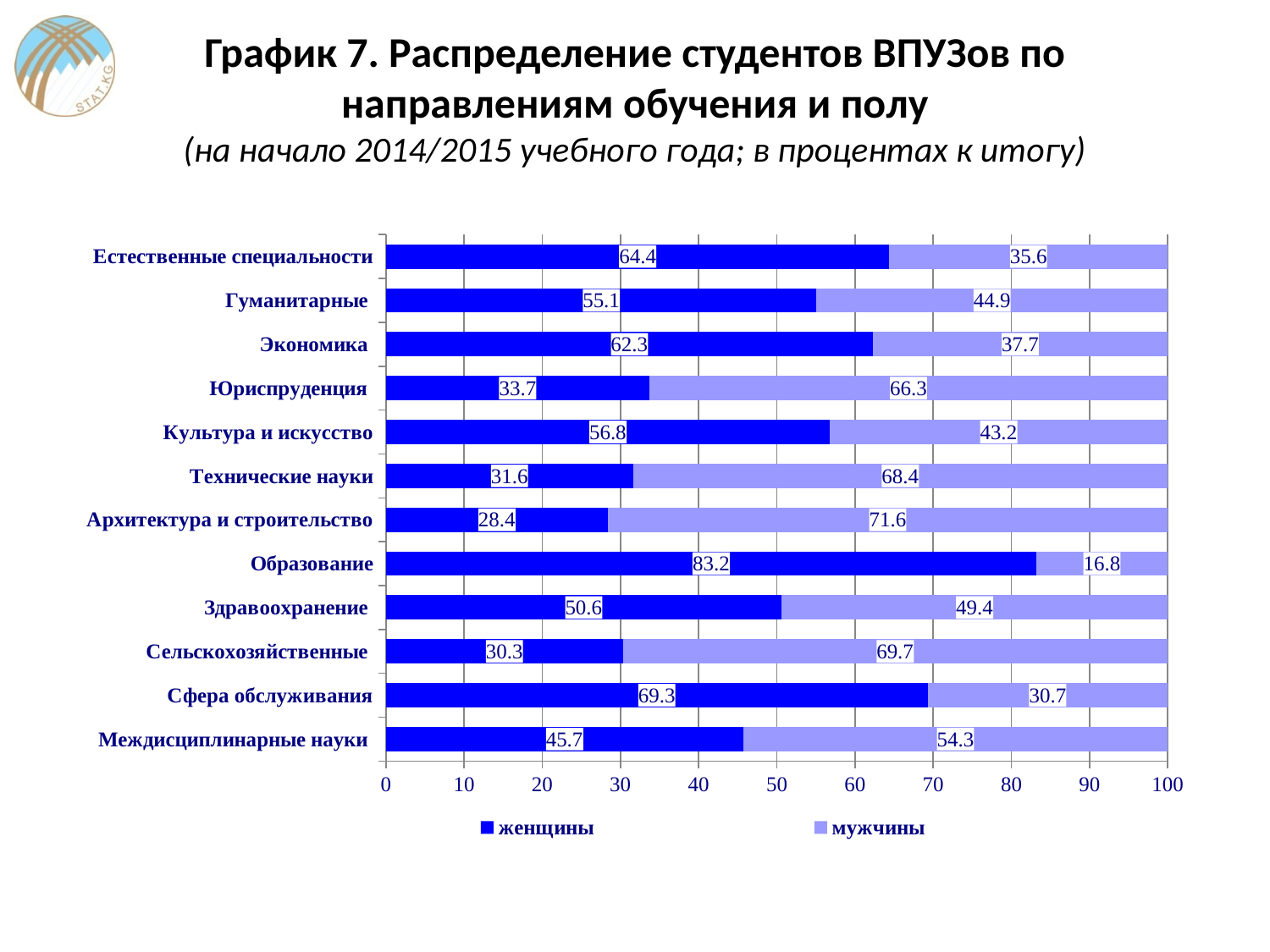
What is the value for мужчины in Архитектура и строительство? 71.6 How many series does the legend list? 2 What is the total of the stacked bar for Здравоохранение? 100 Which field of study has the highest share of женщины? Образование Which field of study has the lowest share of мужчины? Образование Which field of study has the lowest share of женщины? Архитектура и строительство Which is larger: the share of женщины in Экономика or in Гуманитарные? Экономика How many fields of study are shown on the chart? 12 What share of students in Образование are женщины? 83.2 Is the share of мужчины in Технические науки greater or less than 60? greater What is the difference between the женщины and мужчины shares in Юриспруденция? 32.6 What type of chart is shown on the slide? stacked bar chart